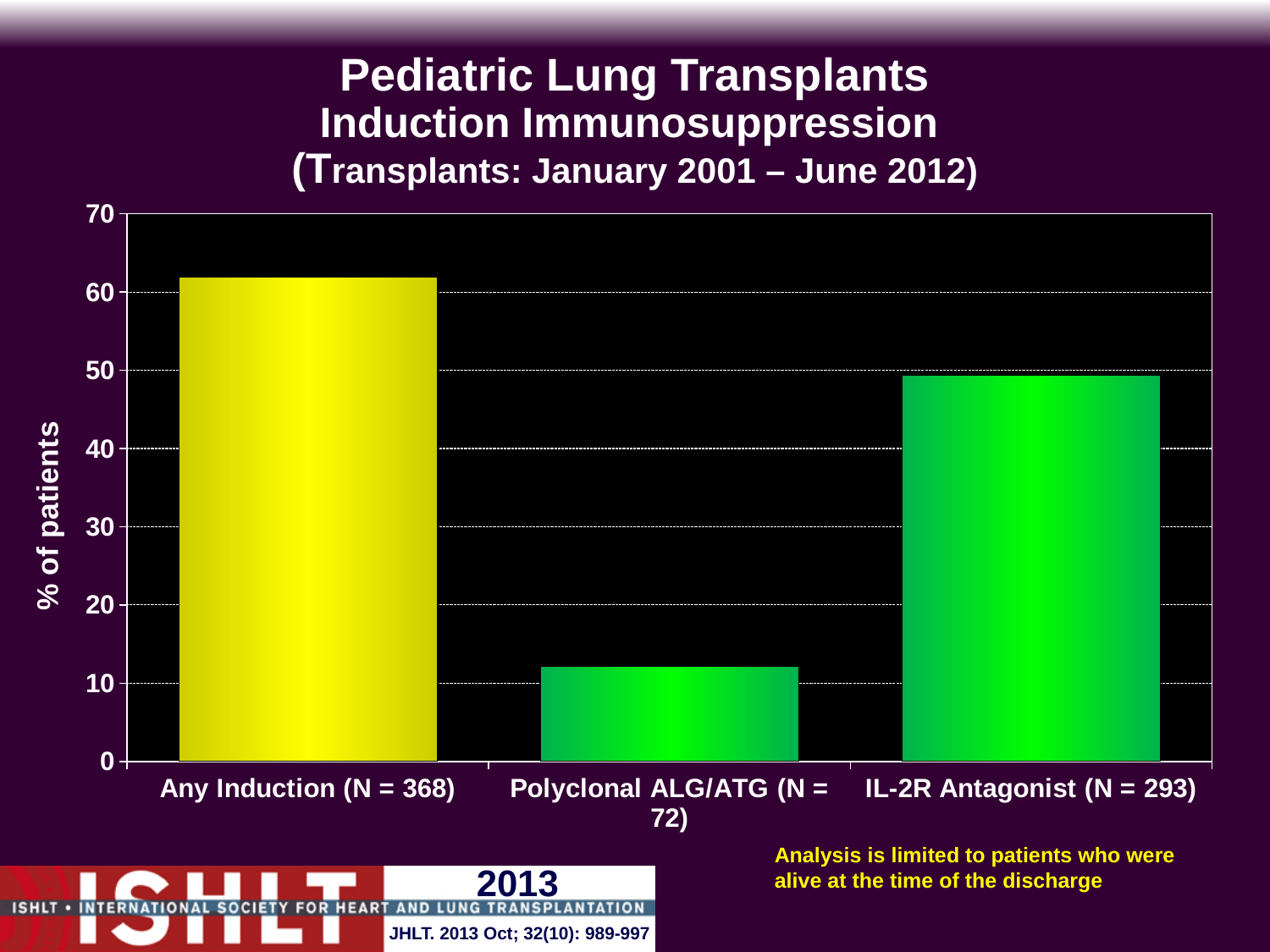
Is the value for Any Induction (N = 368) greater or less than 60? greater Which category has the highest percentage of patients? Any Induction (N = 368) Which is larger, the value for IL-2R Antagonist (N = 293) or the value for Polyclonal ALG/ATG (N = 72)? IL-2R Antagonist (N = 293) Which category has the lowest percentage of patients? Polyclonal ALG/ATG (N = 72) What is the label of the y axis? % of patients Is the value for Polyclonal ALG/ATG (N = 72) greater or less than 20? less Is the value for IL-2R Antagonist (N = 293) greater or less than 40? greater What kind of chart is shown on the slide? bar chart How many categories are plotted in the chart? 3 Which is larger, the value for Any Induction (N = 368) or the value for IL-2R Antagonist (N = 293)? Any Induction (N = 368) What time period of transplants does the chart title cover? January 2001 – June 2012